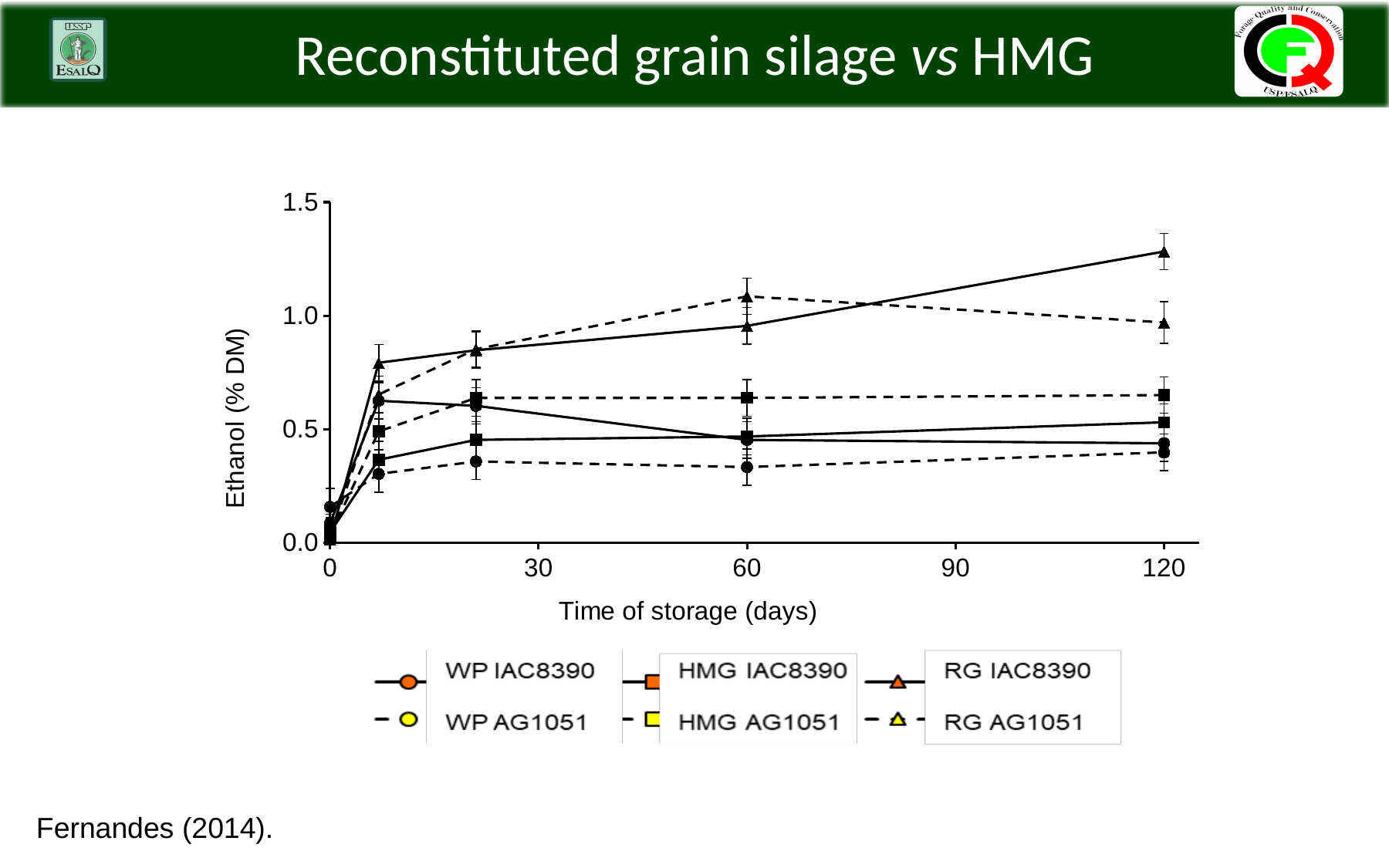
Which series has the highest ethanol value at 120 days of storage? RG IAC8390 Is the ethanol value for HMG AG1051 at 120 days greater or less than 0.5? greater What kind of chart is shown on the slide? Line chart What is the label of the x axis? Time of storage (days) Does the ethanol value for RG IAC8390 rise or fall as time of storage increases from 0 to 120 days? rise What is the label of the y axis? Ethanol (% DM) Is the ethanol value for WP AG1051 at 60 days greater or less than 0.5? less How many series does the legend list? 6 Is the ethanol value for RG IAC8390 at 120 days greater or less than 1.0? greater At 120 days, which series has the larger ethanol value: RG IAC8390 or RG AG1051? RG IAC8390 Which series has the highest ethanol value at 60 days of storage? RG AG1051